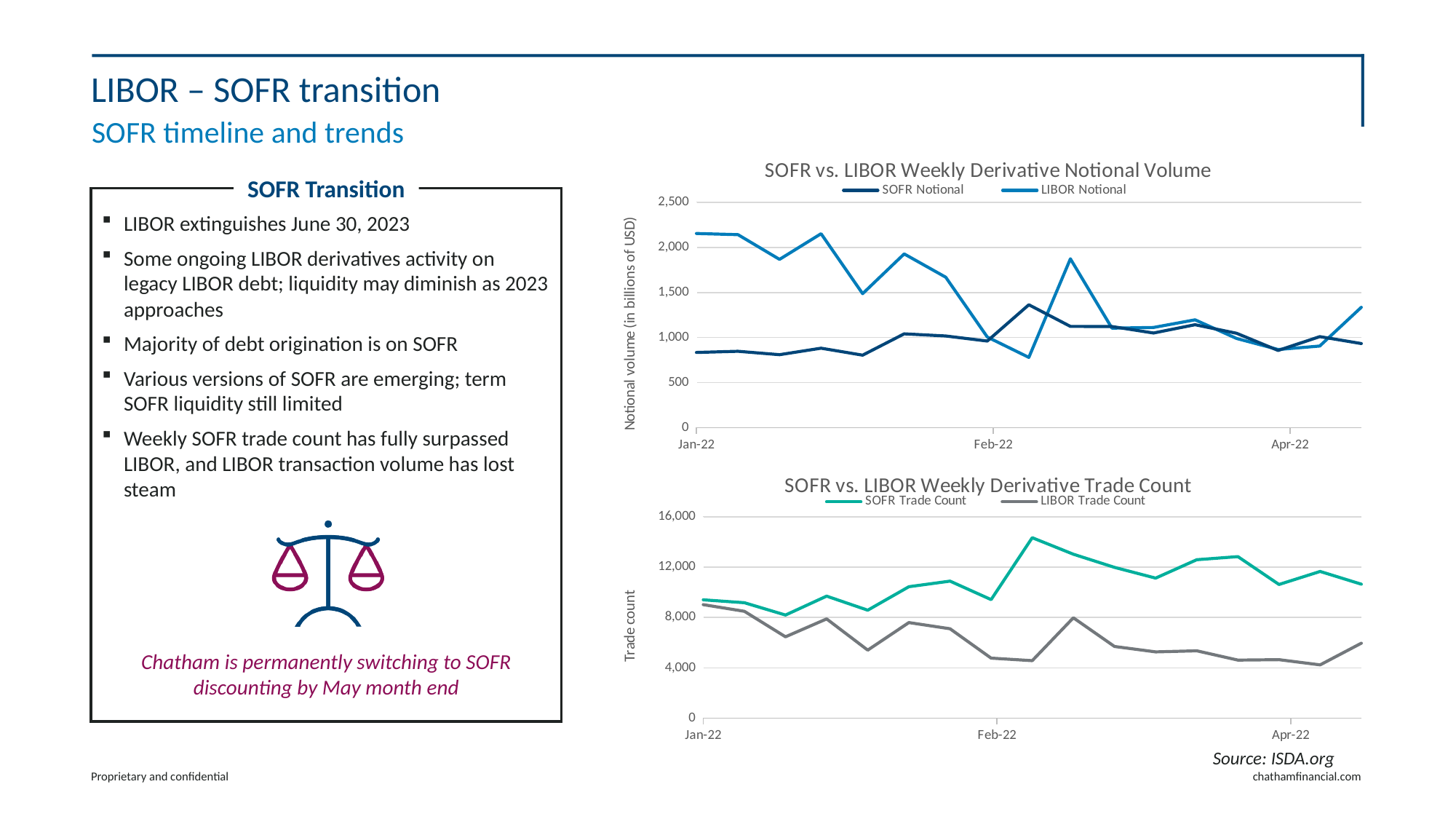
In the "SOFR vs. LIBOR Weekly Derivative Notional Volume" chart, which series is higher at Jan-22, SOFR Notional or LIBOR Notional? LIBOR Notional What is the y-axis label of the "SOFR vs. LIBOR Weekly Derivative Notional Volume" chart? Notional volume (in billions of USD) What kind of chart is the "SOFR vs. LIBOR Weekly Derivative Notional Volume" chart? Line chart In the "SOFR vs. LIBOR Weekly Derivative Trade Count" chart, is the highest SOFR Trade Count value greater or less than 12,000? greater In the "SOFR vs. LIBOR Weekly Derivative Notional Volume" chart, is the SOFR Notional value at Jan-22 greater or less than 1,000? less How many series does the legend of the "SOFR vs. LIBOR Weekly Derivative Notional Volume" chart list? 2 In the "SOFR vs. LIBOR Weekly Derivative Notional Volume" chart, does the LIBOR Notional series overall rise or fall from Jan-22 to Apr-22? fall In the "SOFR vs. LIBOR Weekly Derivative Trade Count" chart, does the LIBOR Trade Count series overall rise or fall from Jan-22 to Apr-22? fall In the "SOFR vs. LIBOR Weekly Derivative Trade Count" chart, is the LIBOR Trade Count value at Apr-22 greater or less than 8,000? less In the "SOFR vs. LIBOR Weekly Derivative Trade Count" chart, which two series are listed in the legend? SOFR Trade Count and LIBOR Trade Count In the "SOFR vs. LIBOR Weekly Derivative Trade Count" chart, which series is higher at Apr-22, SOFR Trade Count or LIBOR Trade Count? SOFR Trade Count